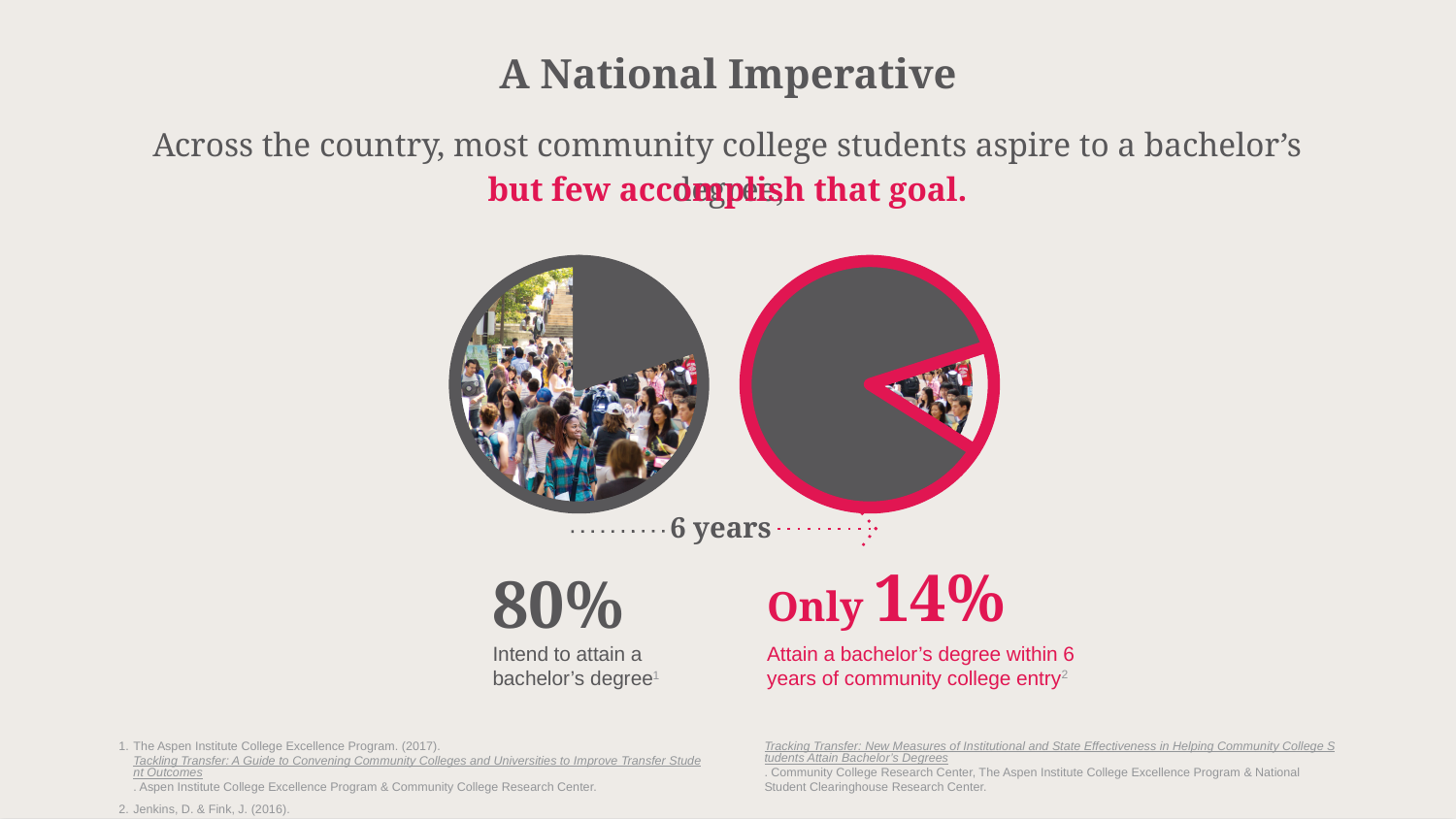
What time period is labelled between the two pie charts? 6 years How many pie charts are on the slide? 2 Which is larger: the share who intend to attain a bachelor's degree (left pie) or the share who attain one within 6 years (right pie)? The share who intend to attain a bachelor's degree (80%) What is the title of the slide containing the two pie charts? A National Imperative In the right pie chart, what share of students attain a bachelor's degree within 6 years of community college entry? 14% Which of the two pie charts shows the smaller highlighted share? The right pie chart (14%) Which of the two pie charts shows the larger highlighted share? The left pie chart (80%) What kind of charts are shown on the slide? Pie charts In the left pie chart, what share of community college students intend to attain a bachelor's degree? 80% What is the difference in percentage points between the share who intend to attain a bachelor's degree (left pie) and the share who attain one within 6 years (right pie)? 66 percentage points